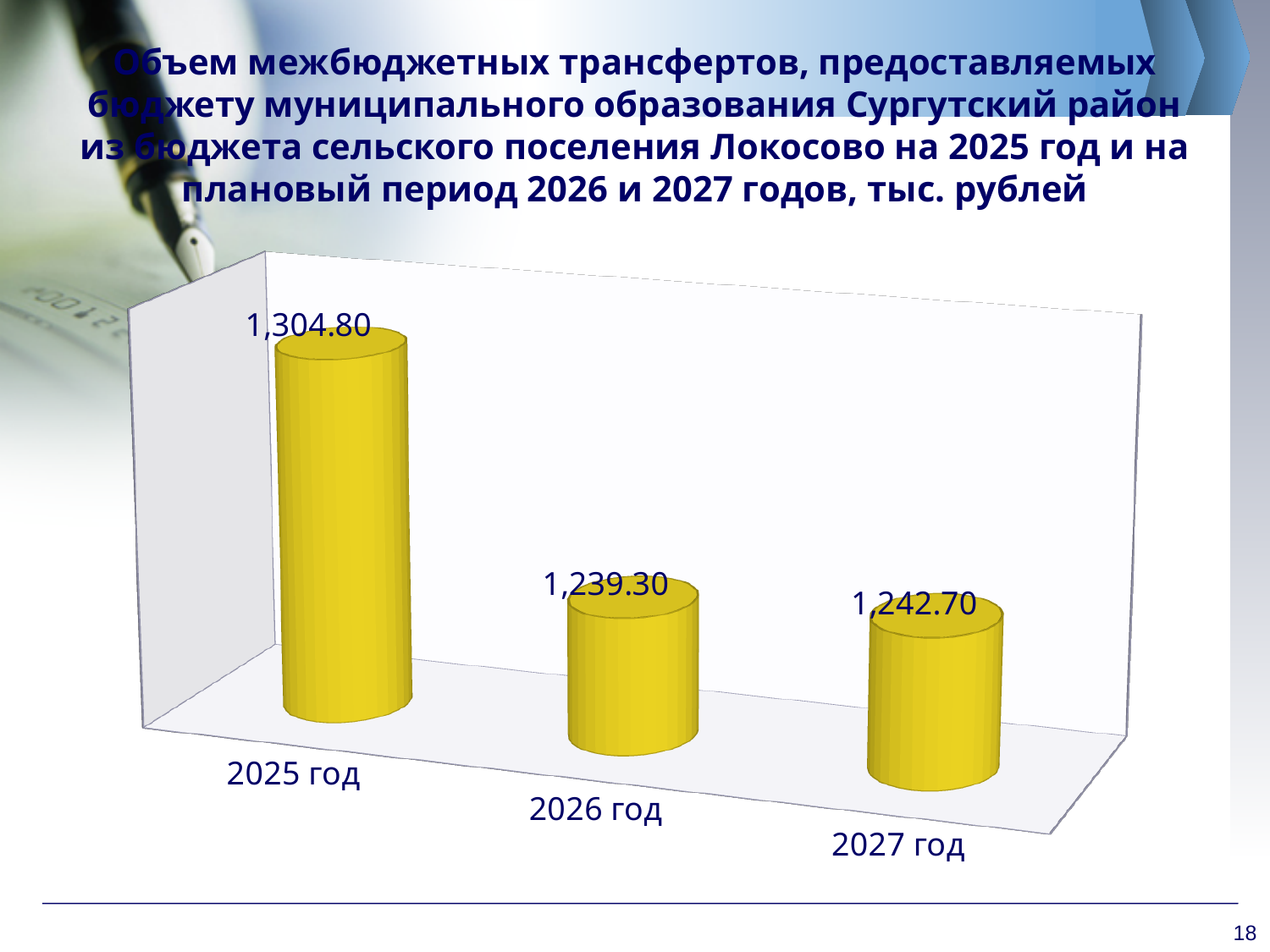
Which is larger, the value for 2025 год or the value for 2027 год? 2025 год What is the difference between the values for 2025 год and 2026 год? 65.50 How many years are shown on the chart? 3 What is the value for 2026 год? 1,239.30 Which year has the highest value? 2025 год What is the value for 2027 год? 1,242.70 Which year has the lowest value? 2026 год What colour are the bars on the chart? yellow What is the value for 2025 год? 1,304.80 What is the difference between the values for 2027 год and 2026 год? 3.40 Do the values rise or fall from 2025 год to 2026 год? fall What kind of chart is shown on the slide? bar chart